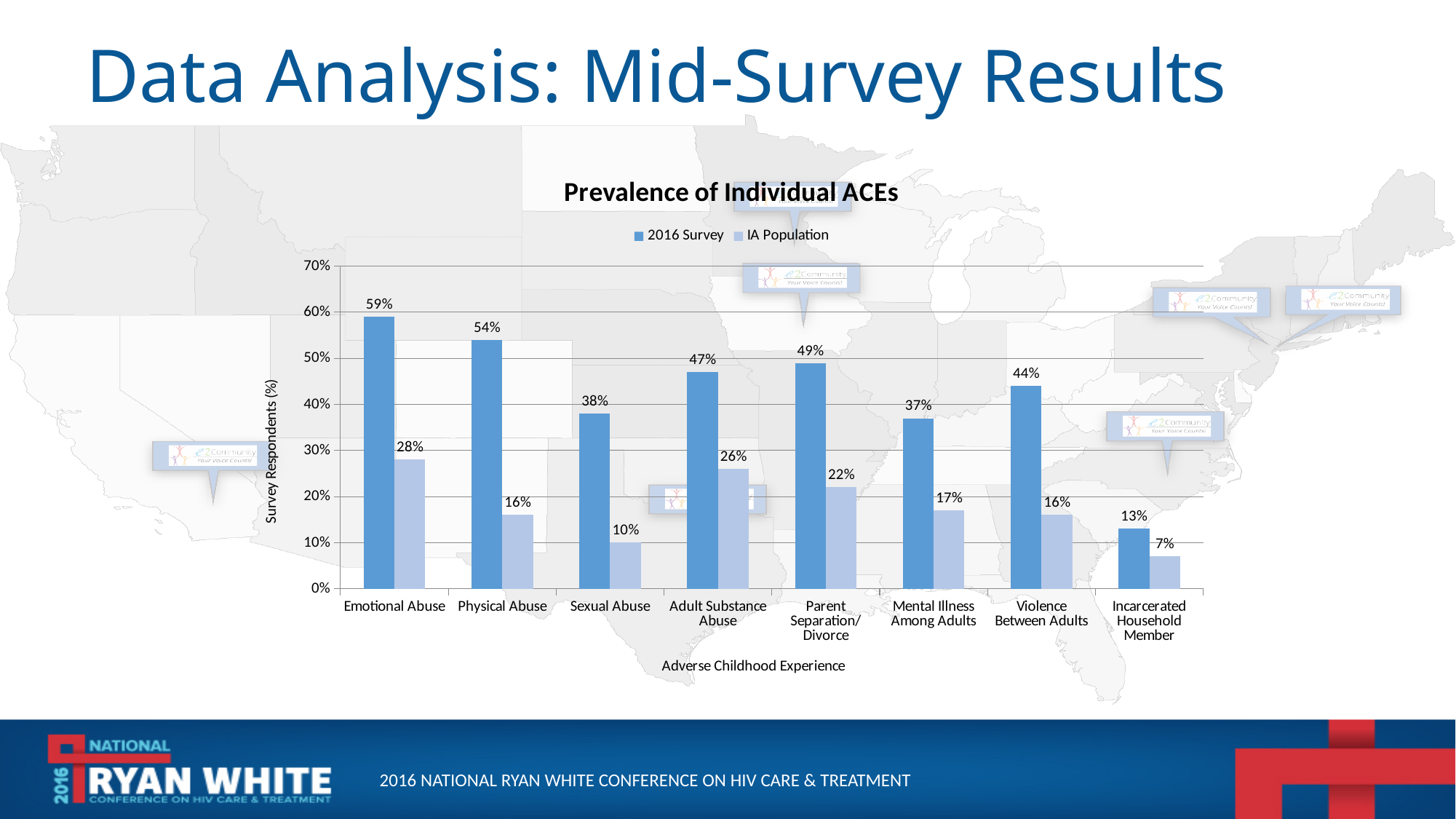
What kind of chart is shown? Bar chart What is the title of the chart? Prevalence of Individual ACEs How many categories are shown on the x axis? 8 Which category has the highest 2016 Survey value? Emotional Abuse Which is larger: the 2016 Survey value for Sexual Abuse or the 2016 Survey value for Violence Between Adults? Violence Between Adults Which category has the lowest IA Population value? Incarcerated Household Member What is the 2016 Survey value for Incarcerated Household Member? 13% What is the label of the y axis? Survey Respondents (%) What is the IA Population value for Adult Substance Abuse? 26% How many series does the legend list? 2 What is the difference between the 2016 Survey and IA Population values for Physical Abuse? 38% What is the 2016 Survey value for Emotional Abuse? 59%